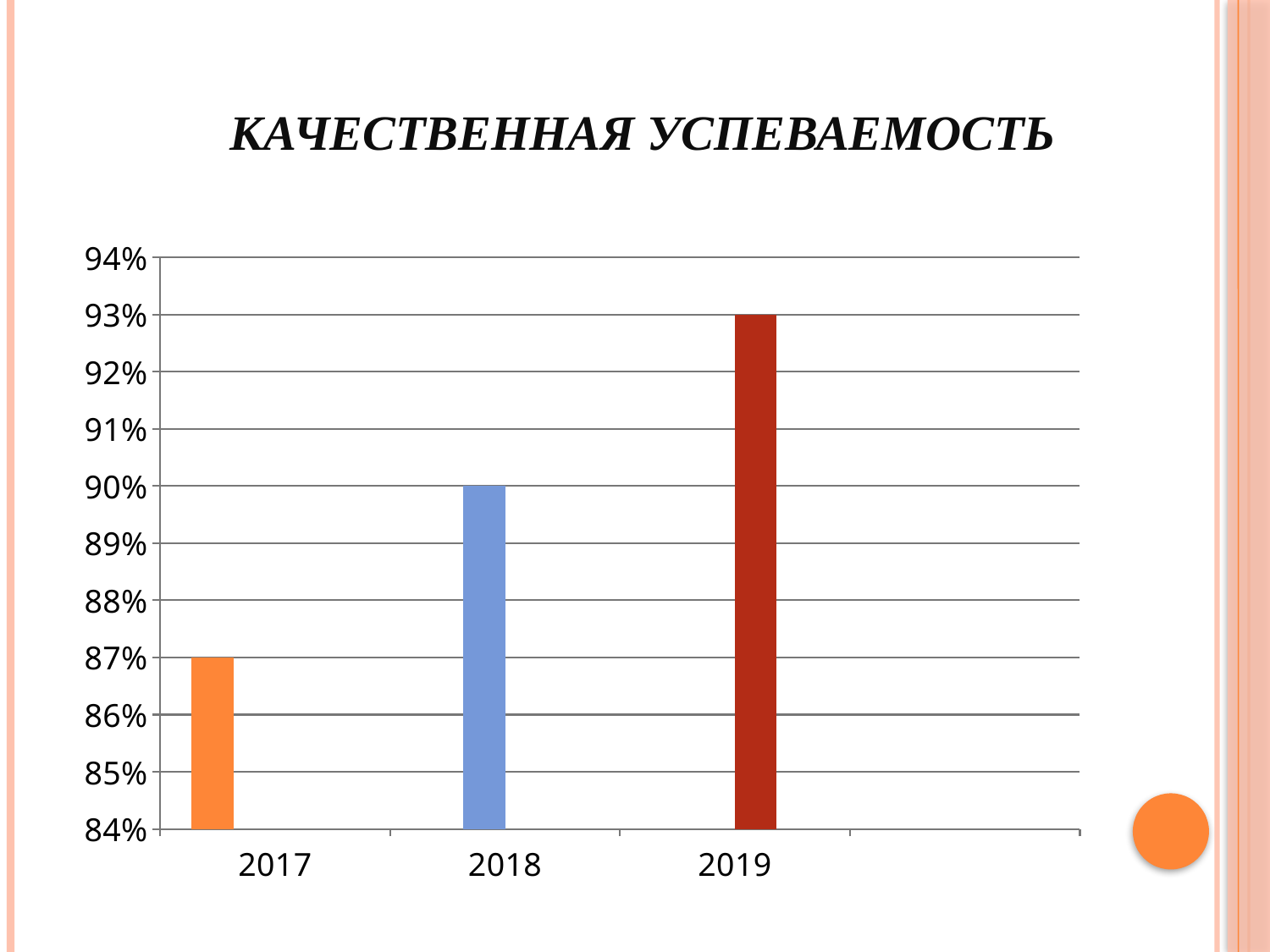
What kind of chart is shown on the slide? bar chart What is the value for 2019? 93% Which year has the highest value? 2019 Do the values rise or fall from 2017 to 2019? rise What is the value for 2018? 90% Is the value for 2018 greater or less than 89%? greater Which year has the lowest value? 2017 Which is larger, the value for 2018 or the value for 2019? 2019 How many years are shown on the x axis? 3 What is the difference between the values for 2019 and 2017? 6% What is the difference between the values for 2018 and 2017? 3% What is the value for 2017? 87%